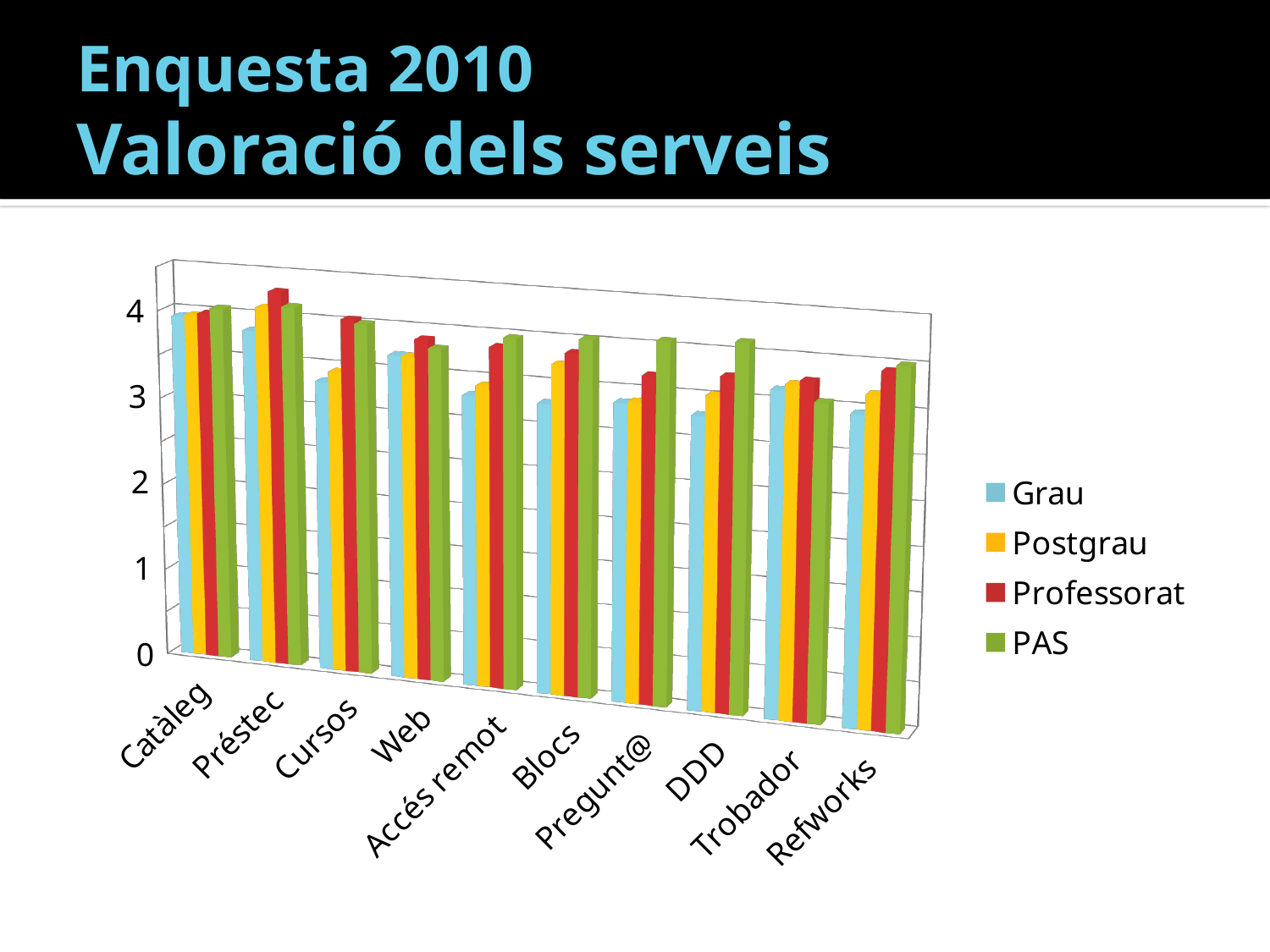
How many series does the legend list? 4 Which series has the highest value for Préstec? Professorat Is the Professorat value for Cursos greater or less than 3? greater Which series does the legend list last? PAS What kind of chart is shown on the slide? bar chart For Blocs, which is larger, the Grau value or the PAS value? PAS Which series has the lowest value for Cursos? Grau Is the Professorat value for Préstec greater or less than 4? greater How many service categories are shown on the x axis? 10 Do the Grau values generally rise or fall from Catàleg to Refworks? fall